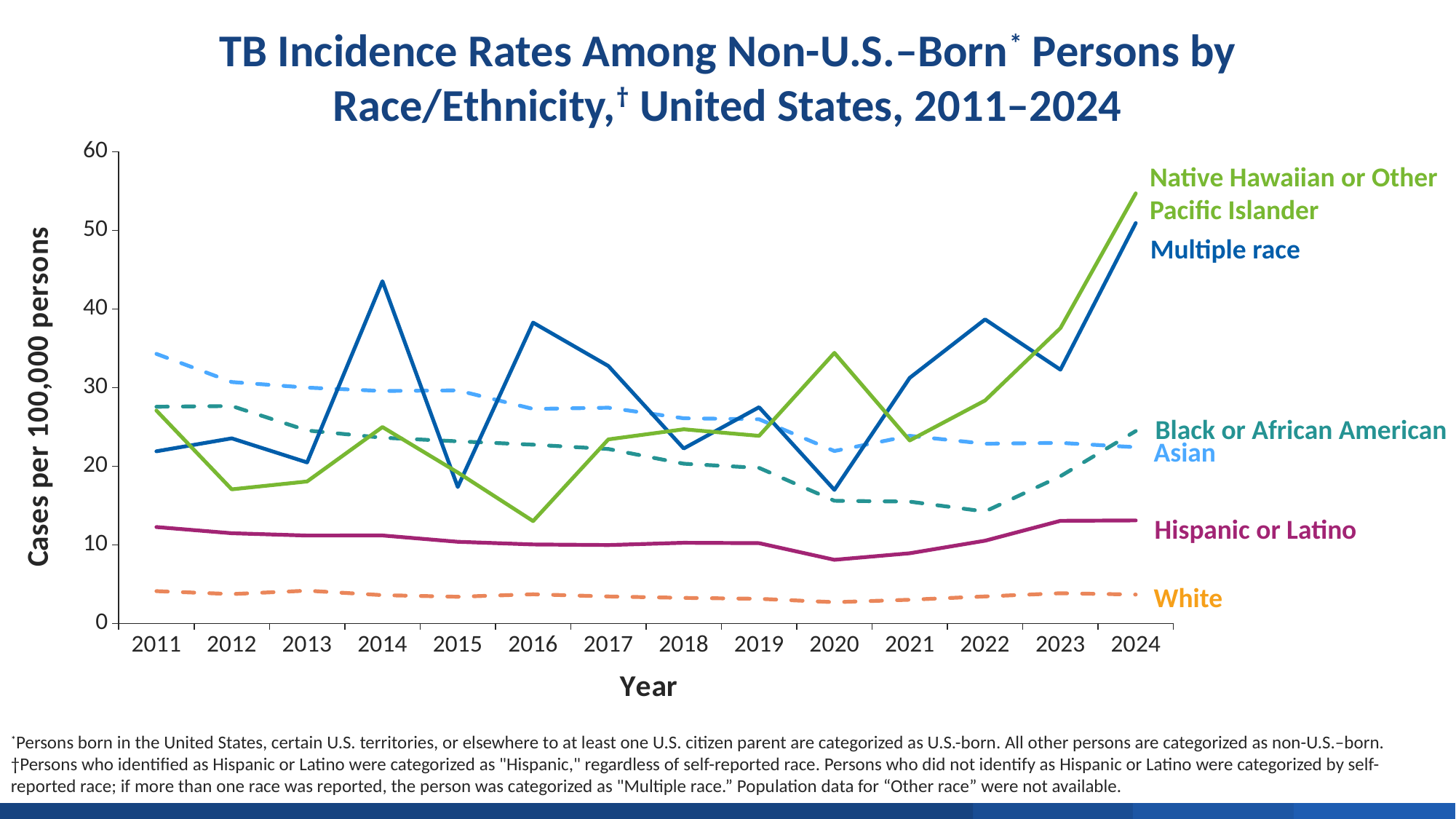
What is the label on the y axis of the chart? Cases per 100,000 persons How many race/ethnicity series are plotted on the chart? 6 Which race/ethnicity group has the highest TB incidence rate in 2024? Native Hawaiian or Other Pacific Islander What kind of chart is shown on the slide? line chart Which race/ethnicity group has the lowest TB incidence rate across all years shown? White How many years are shown along the x axis? 14 Does the Asian TB incidence rate rise or fall from 2011 to 2020? fall In 2020, which is larger: the rate for Native Hawaiian or Other Pacific Islander or the rate for Multiple race? Native Hawaiian or Other Pacific Islander Is the value for White in 2011 greater or less than 10? less Is the value for Native Hawaiian or Other Pacific Islander in 2024 greater or less than 50? greater Is the value for Multiple race in 2014 greater or less than 40? greater Which race/ethnicity group has the highest TB incidence rate in 2011? Asian